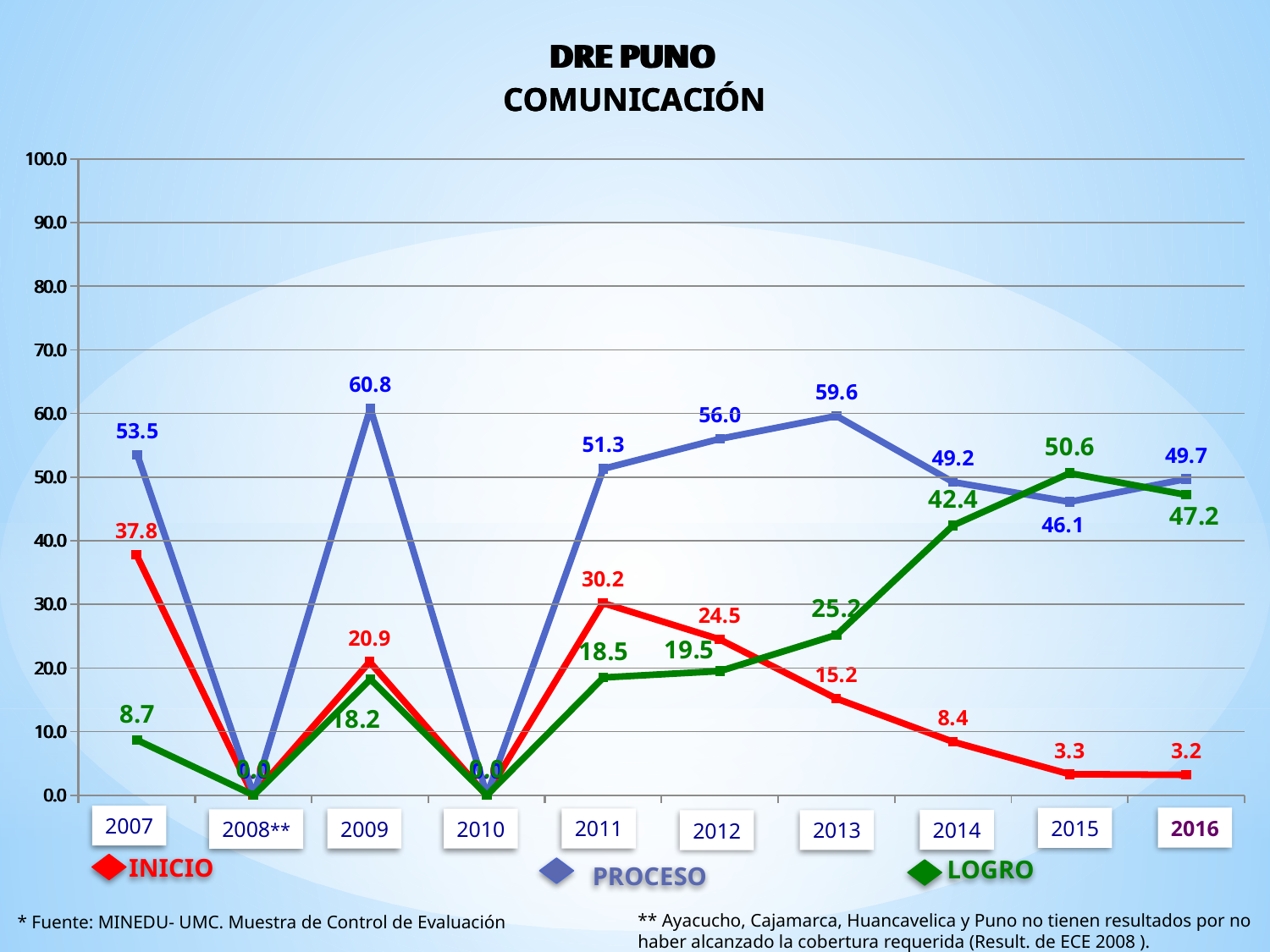
Is the PROCESO value for 2012 greater or less than 50.0? greater How many years are shown on the x axis? 10 What is the LOGRO value for 2016? 47.2 What is the difference between the PROCESO and INICIO values in 2013? 44.4 In which year does the LOGRO series reach its highest value? 2015 Does the INICIO series rise or fall from 2011 to 2016? fall Which is larger in 2015, the LOGRO value or the PROCESO value? LOGRO What is the PROCESO value for 2009? 60.8 What is the INICIO value for 2007? 37.8 How many series does the legend list? 3 In which year does the PROCESO series reach its highest value? 2009 What kind of chart is shown on the slide? line chart